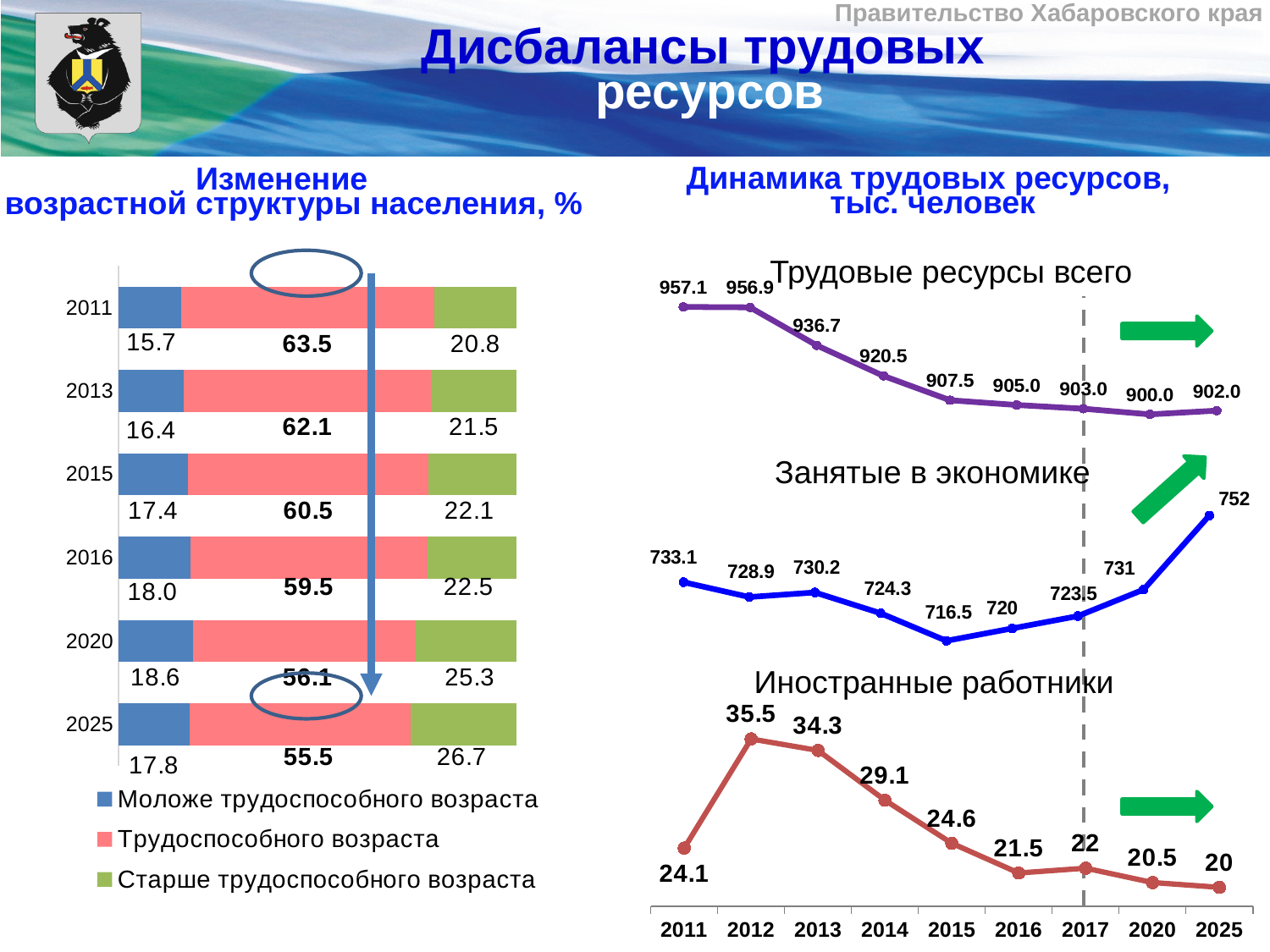
In the chart 'Изменение возрастной структуры населения, %', how many series does the legend list? 3 What kind of chart is 'Изменение возрастной структуры населения, %'? stacked bar chart In the chart 'Изменение возрастной структуры населения, %', what is the value for 'Старше трудоспособного возраста' in 2025? 26.7 In the chart 'Динамика трудовых ресурсов, тыс. человек', which is larger: 'Иностранные работники' in 2011 or in 2015? 2015 In the chart 'Изменение возрастной структуры населения, %', how many years are shown? 6 In the chart 'Динамика трудовых ресурсов, тыс. человек', in which year is 'Занятые в экономике' lowest? 2015 In the chart 'Динамика трудовых ресурсов, тыс. человек', what is the value of 'Трудовые ресурсы всего' in 2013? 936.7 In the chart 'Изменение возрастной структуры населения, %', what is the value for 'Трудоспособного возраста' in 2011? 63.5 In the chart 'Динамика трудовых ресурсов, тыс. человек', what is the difference between 'Занятые в экономике' in 2025 and in 2020? 21 In the chart 'Изменение возрастной структуры населения, %', what is the difference between the 'Трудоспособного возраста' values for 2011 and 2025? 8.0 In the chart 'Изменение возрастной структуры населения, %', does the 'Старше трудоспособного возраста' share rise or fall from 2011 to 2025? rise In the chart 'Динамика трудовых ресурсов, тыс. человек', in which year is 'Иностранные работники' highest? 2012